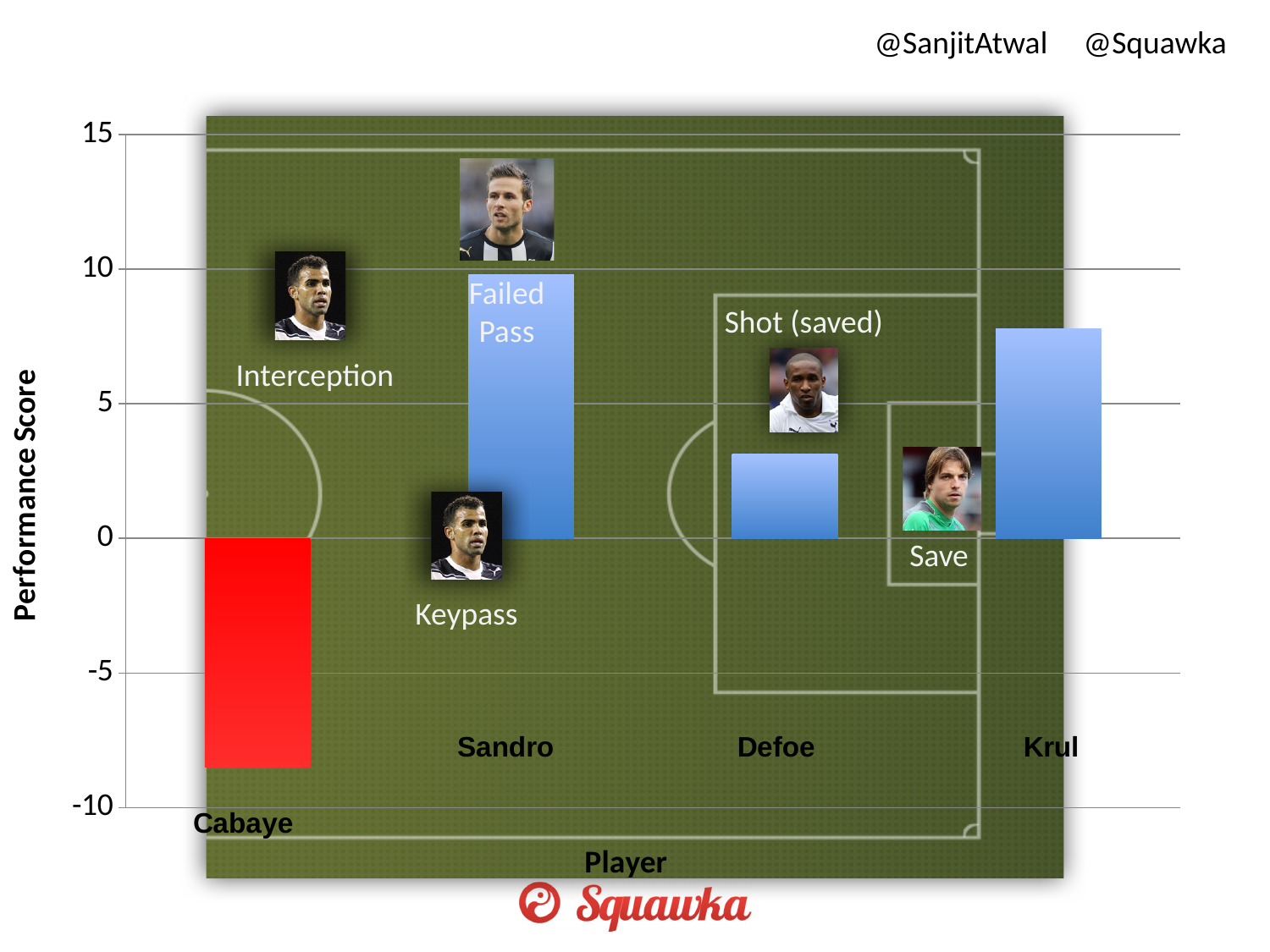
Is the performance score for Defoe greater or less than 5? less Which player has the lowest performance score? Cabaye Is the performance score for Krul greater or less than 5? greater Which player's bar is coloured red? Cabaye Which player has the higher performance score, Sandro or Krul? Sandro Which player has the higher performance score, Defoe or Krul? Krul Is the performance score for Cabaye greater or less than -5? less How many players are shown on the x axis of the chart? 4 What is the title of the vertical axis? Performance Score Which player has the highest performance score? Sandro What kind of chart is shown on the slide? bar chart